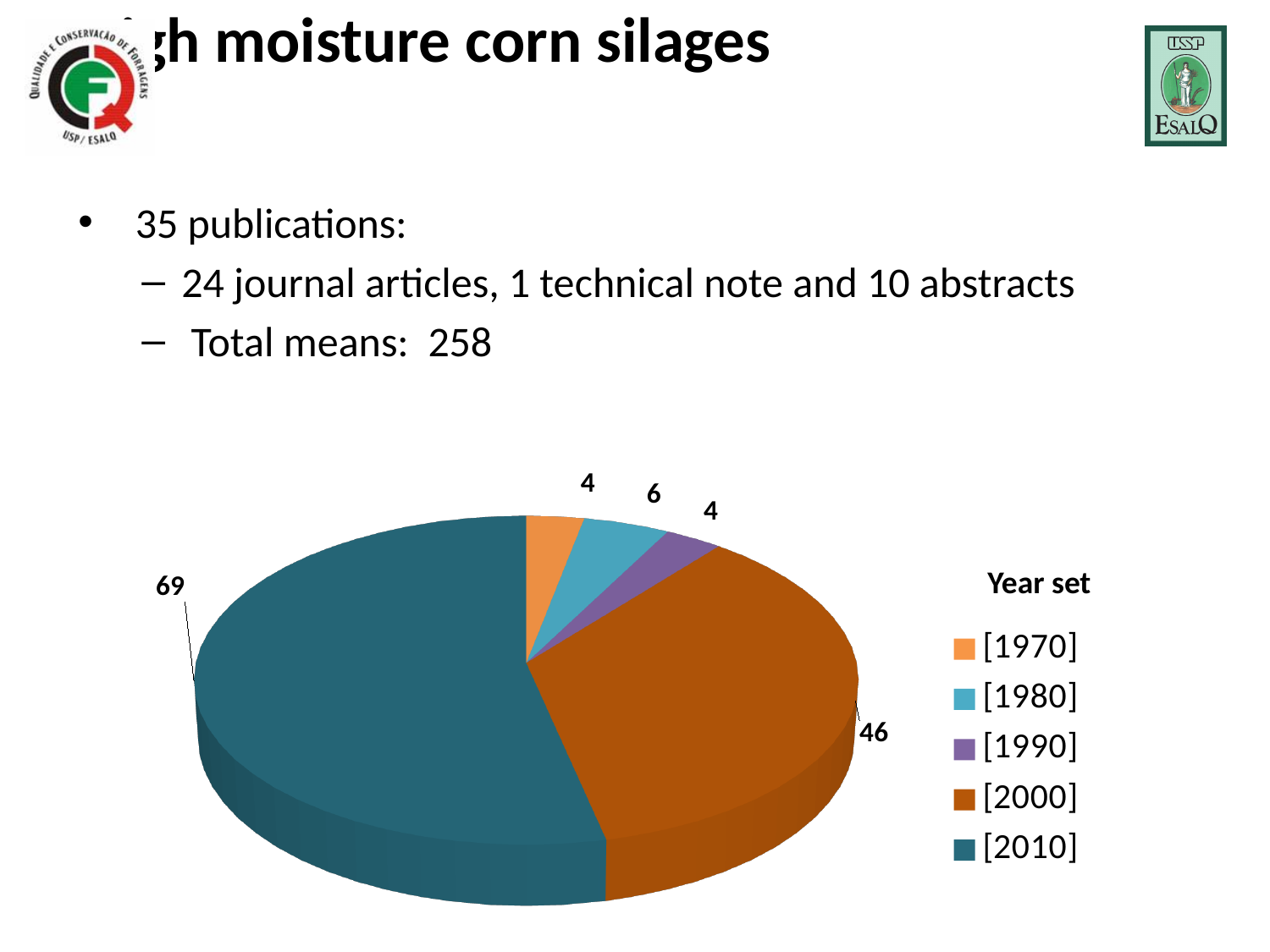
How many year-set categories does the pie chart show? 5 What colour is the [2000] slice in the pie chart? Brown Which year set has the largest slice in the pie chart? [2010] What value is shown for the [2000] slice of the pie chart? 46 What kind of chart is shown on the slide? Pie chart What value is shown for the [1980] slice of the pie chart? 6 What value is shown for the [1970] slice of the pie chart? 4 What is the total of all the slice values in the pie chart? 129 What is the title of the chart legend? Year set What value is shown for the [2010] slice of the pie chart? 69 What is the difference between the values for [2010] and [2000]? 23 Which is larger, the value for [1980] or the value for [1990]? [1980]